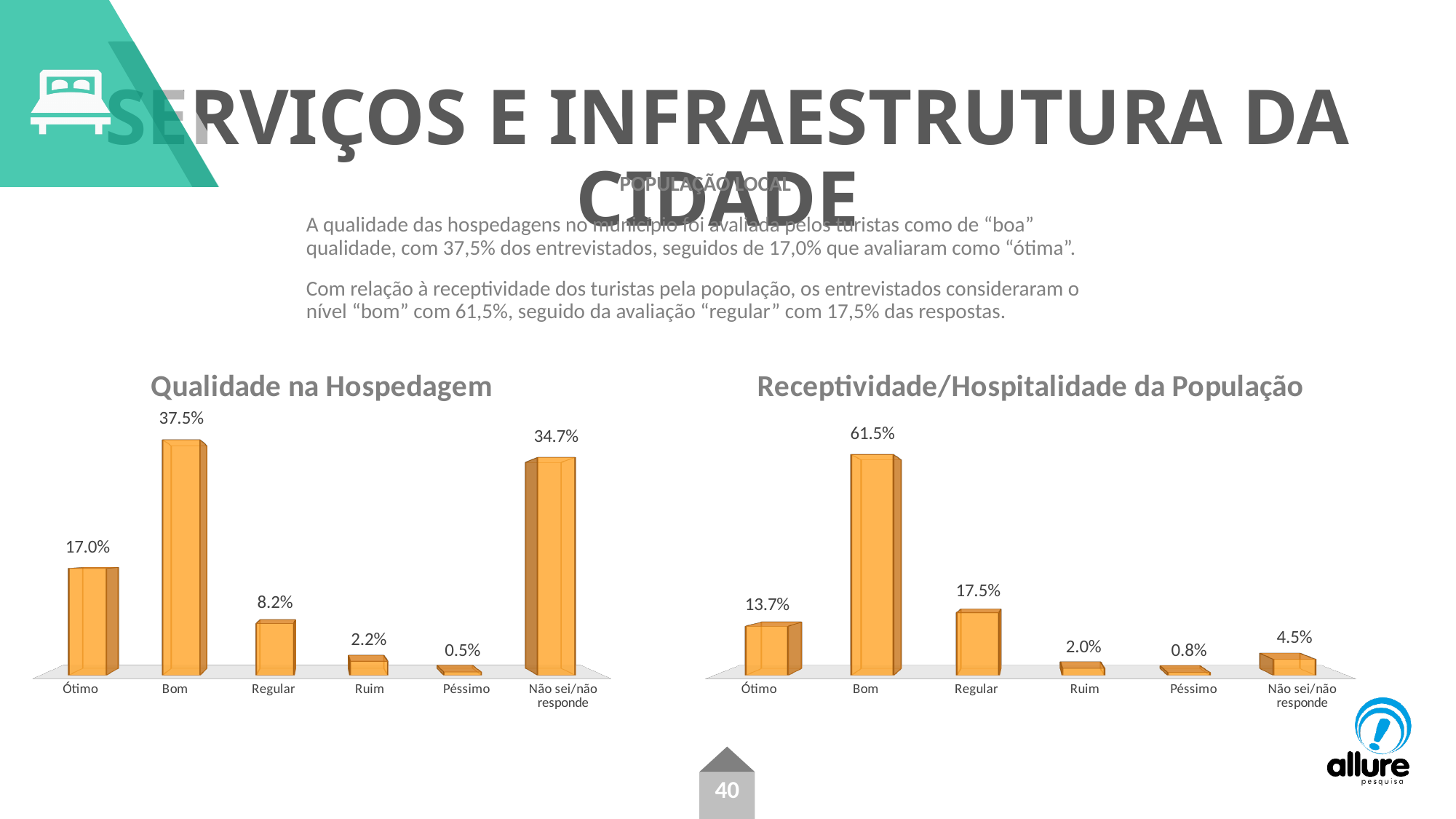
In the 'Qualidade na Hospedagem' chart, how many categories are shown? 6 What is the title of the chart on the right side of the slide? Receptividade/Hospitalidade da População In the 'Receptividade/Hospitalidade da População' chart, what is the value for Regular? 17.5% In the 'Receptividade/Hospitalidade da População' chart, which is larger, Ótimo or Regular? Regular In the 'Qualidade na Hospedagem' chart, what is the difference between Bom and Ótimo? 20.5% In the 'Qualidade na Hospedagem' chart, which category has the lowest value? Péssimo In the 'Qualidade na Hospedagem' chart, what is the value for Não sei/não responde? 34.7% In the 'Receptividade/Hospitalidade da População' chart, which category has the highest value? Bom In the 'Receptividade/Hospitalidade da População' chart, what is the value for Bom? 61.5% In the 'Qualidade na Hospedagem' chart, what is the value for Bom? 37.5% What type of chart is the 'Qualidade na Hospedagem' chart? Bar chart In the 'Receptividade/Hospitalidade da População' chart, what is the difference between Regular and Ótimo? 3.8%